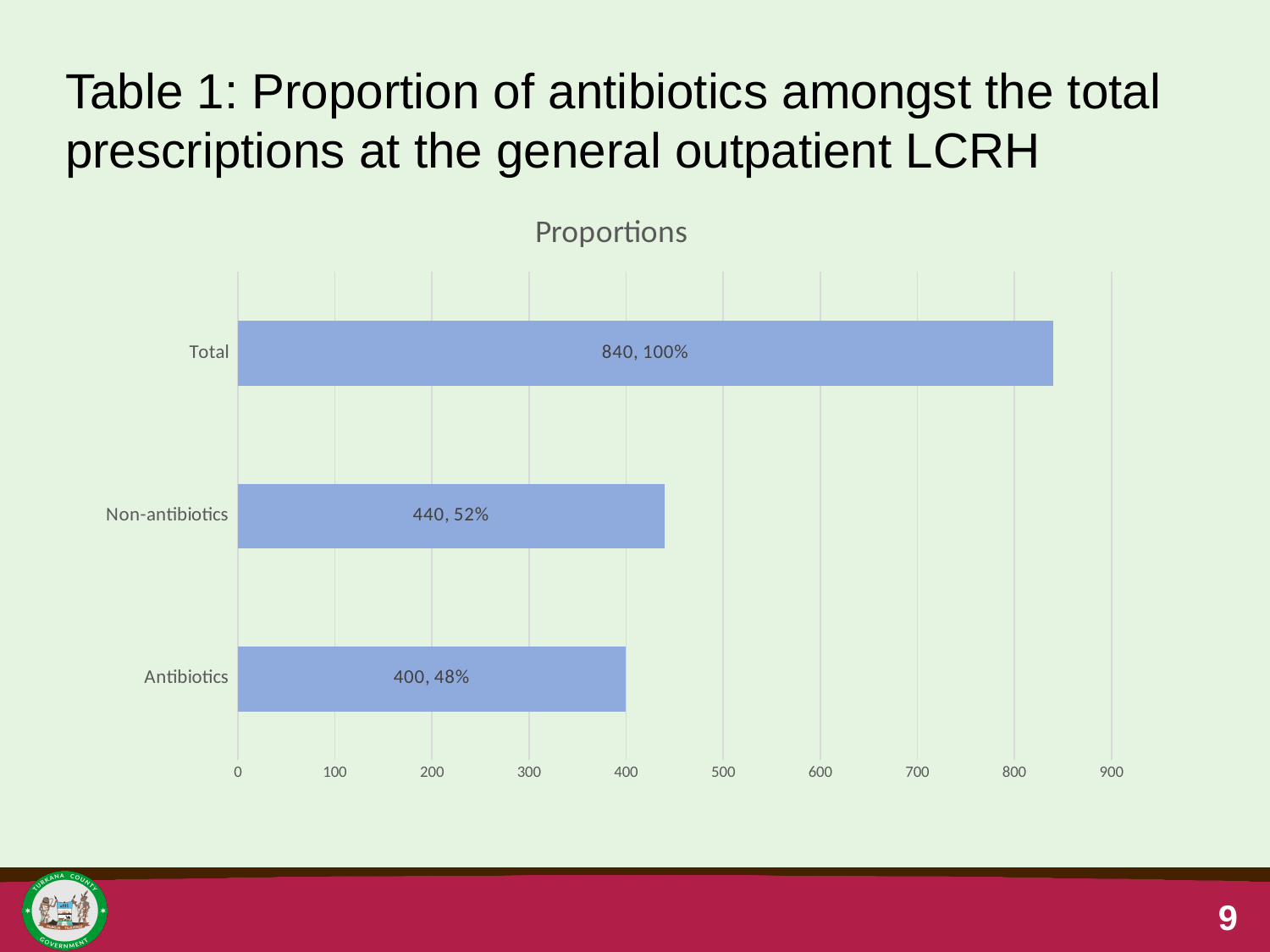
What is the value for Total? 840 What percentage is shown for Non-antibiotics? 52% What is the title of the chart? Proportions What percentage is shown for Antibiotics? 48% Which is larger, the value for Non-antibiotics or the value for Antibiotics? Non-antibiotics What is the value for Non-antibiotics? 440 How many categories are shown in the chart? 3 Which category has the lowest value? Antibiotics What kind of chart is shown? Bar chart Which category has the highest value? Total What is the difference between the Non-antibiotics and Antibiotics values? 40 What is the value for Antibiotics? 400